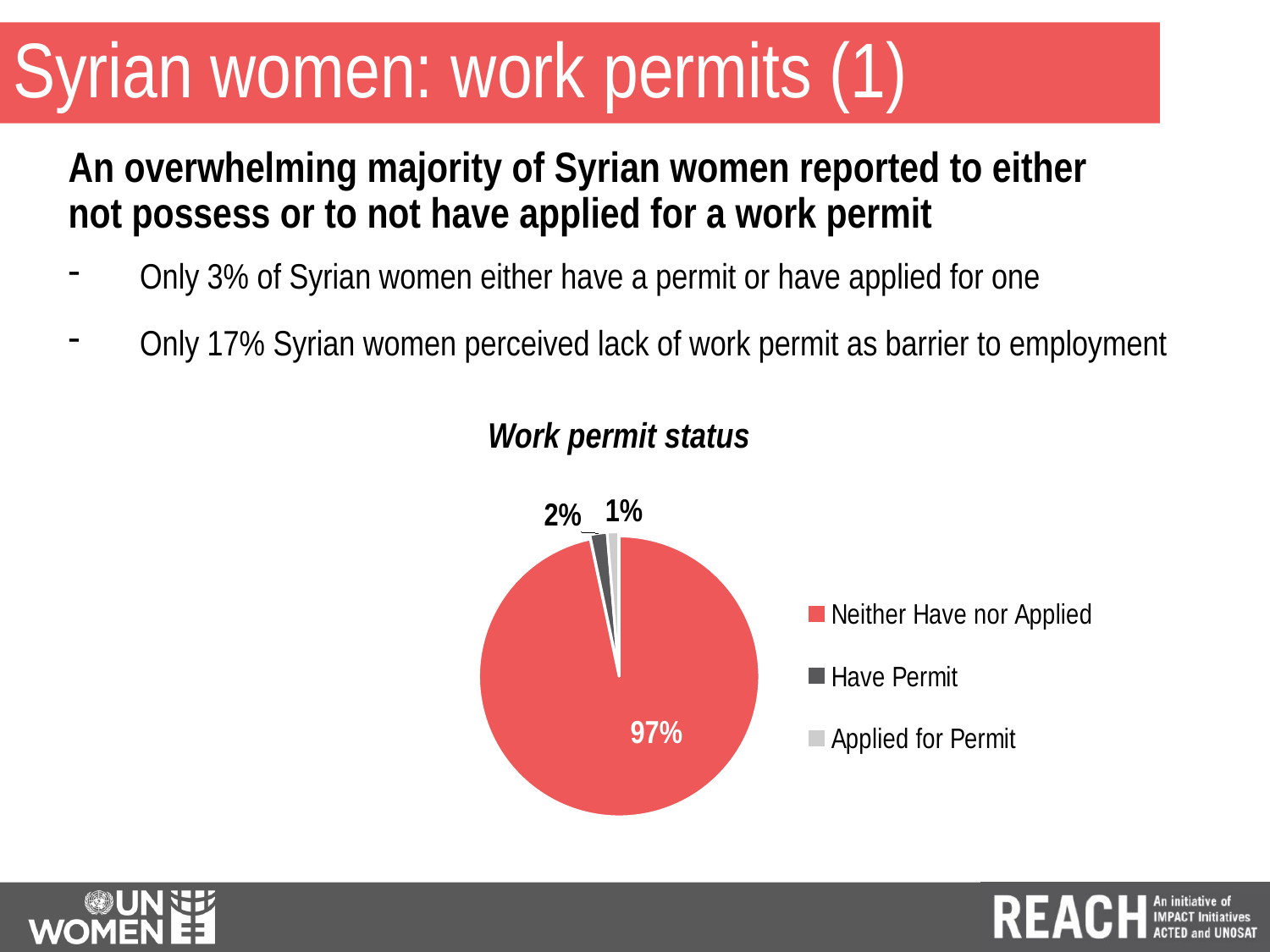
Which category has the smallest slice of the pie? Applied for Permit What colour is the "Neither Have nor Applied" slice? red What is the combined share of "Have Permit" and "Applied for Permit"? 3% What share of the pie is "Neither Have nor Applied"? 97% Which is larger, the "Have Permit" slice or the "Applied for Permit" slice? Have Permit What is the title of the chart? Work permit status What is the difference between the "Neither Have nor Applied" share and the "Have Permit" share? 95% What share of the pie is "Have Permit"? 2% Which category has the largest slice of the pie? Neither Have nor Applied How many categories does the pie chart show? 3 What kind of chart is shown under the title "Work permit status"? pie chart What share of the pie is "Applied for Permit"? 1%